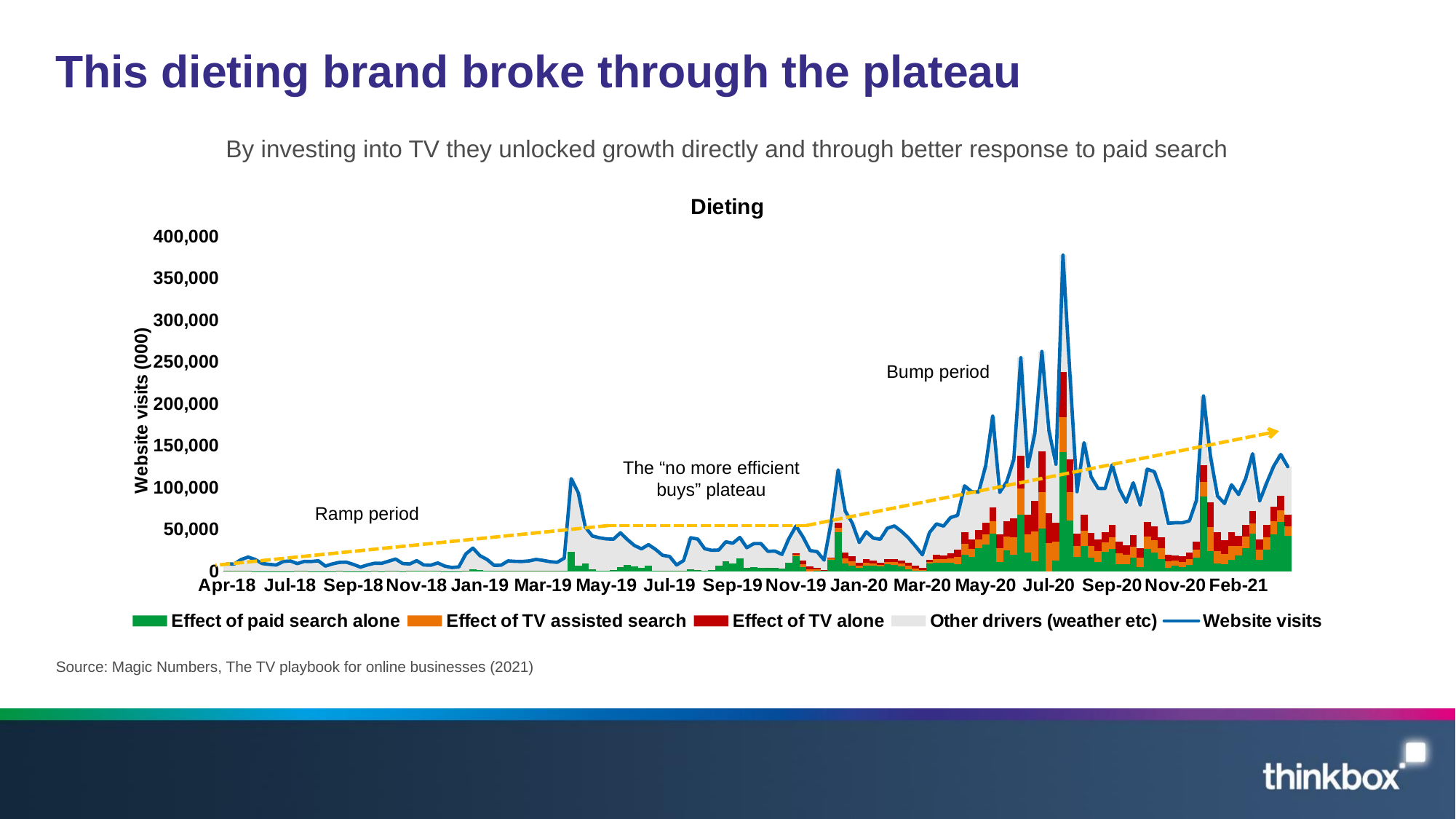
Overall, do website visits rise or fall from Apr-18 to Feb-21? rise Is the highest peak of the Website visits line greater or less than 350,000? greater How many series does the legend list? 5 Is the value of the Website visits line at Apr-18 greater or less than 50,000? less Around which labelled month does the Website visits line reach its highest peak? Jul-20 Which is larger: the Website visits peak around Jul-20 or the peak around Mar-19? Jul-20 What kind of chart is this? Stacked bar chart with a line overlay Is the peak of the Website visits line around Jan-20 greater or less than 100,000? greater What is the title of the chart? Dieting How many month labels are shown on the x axis? 17 What is the label on the vertical axis? Website visits (000)